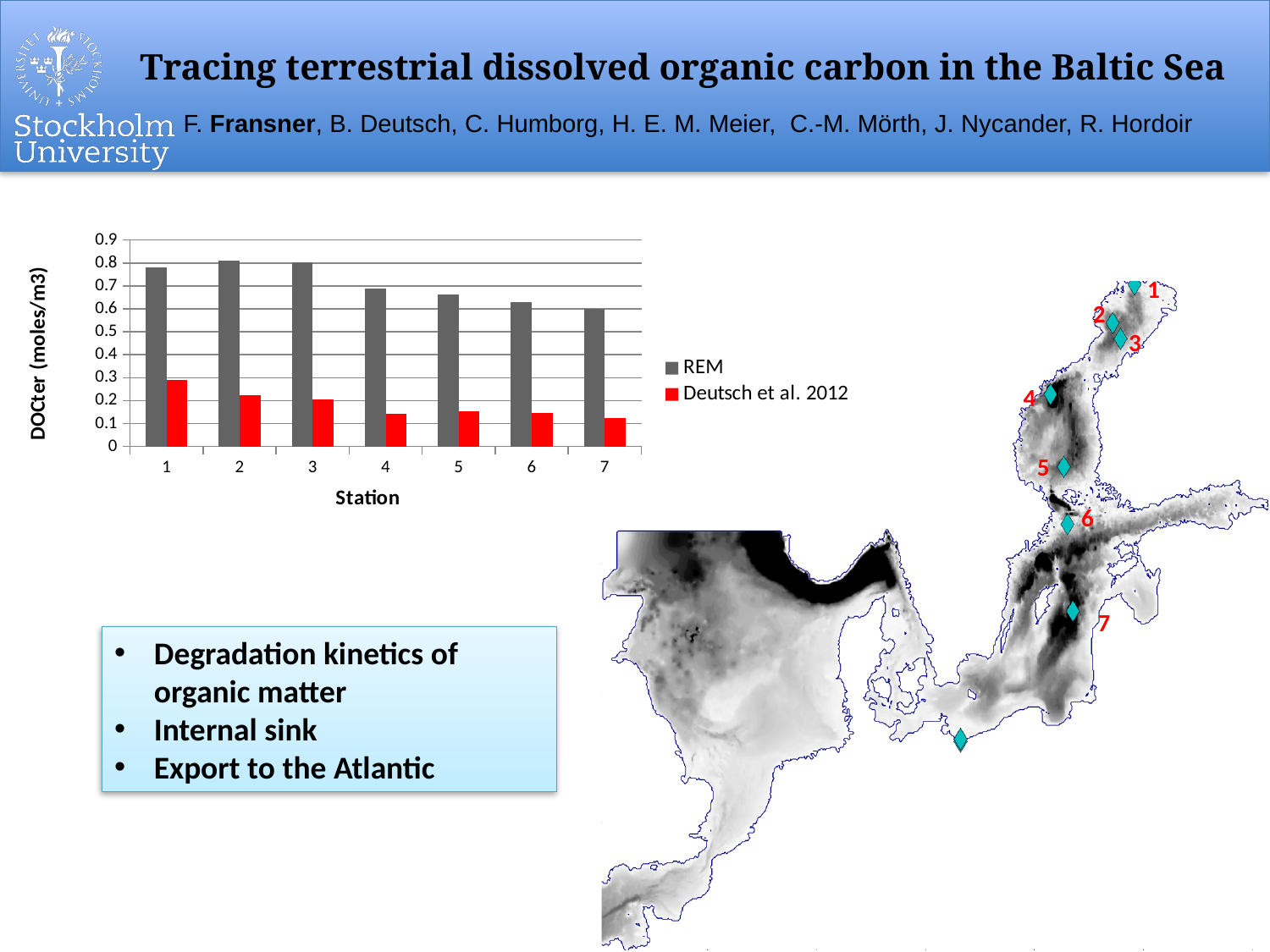
Which station has the highest value for the Deutsch et al. 2012 series? 1 What kind of chart is shown on the slide? bar chart Is the Deutsch et al. 2012 value for station 4 greater or less than 0.2? less Is the REM value for station 7 greater or less than 0.7? less Is the REM value for station 1 greater or less than 0.7? greater At station 3, which series has the larger value, REM or Deutsch et al. 2012? REM What is the label on the y axis of the chart? DOCter (moles/m3) How many series does the chart legend list? 2 For the REM series, which station has the larger value, station 1 or station 7? station 1 How many stations are shown on the x axis of the chart? 7 Do the REM values generally rise or fall from station 1 to station 7? fall